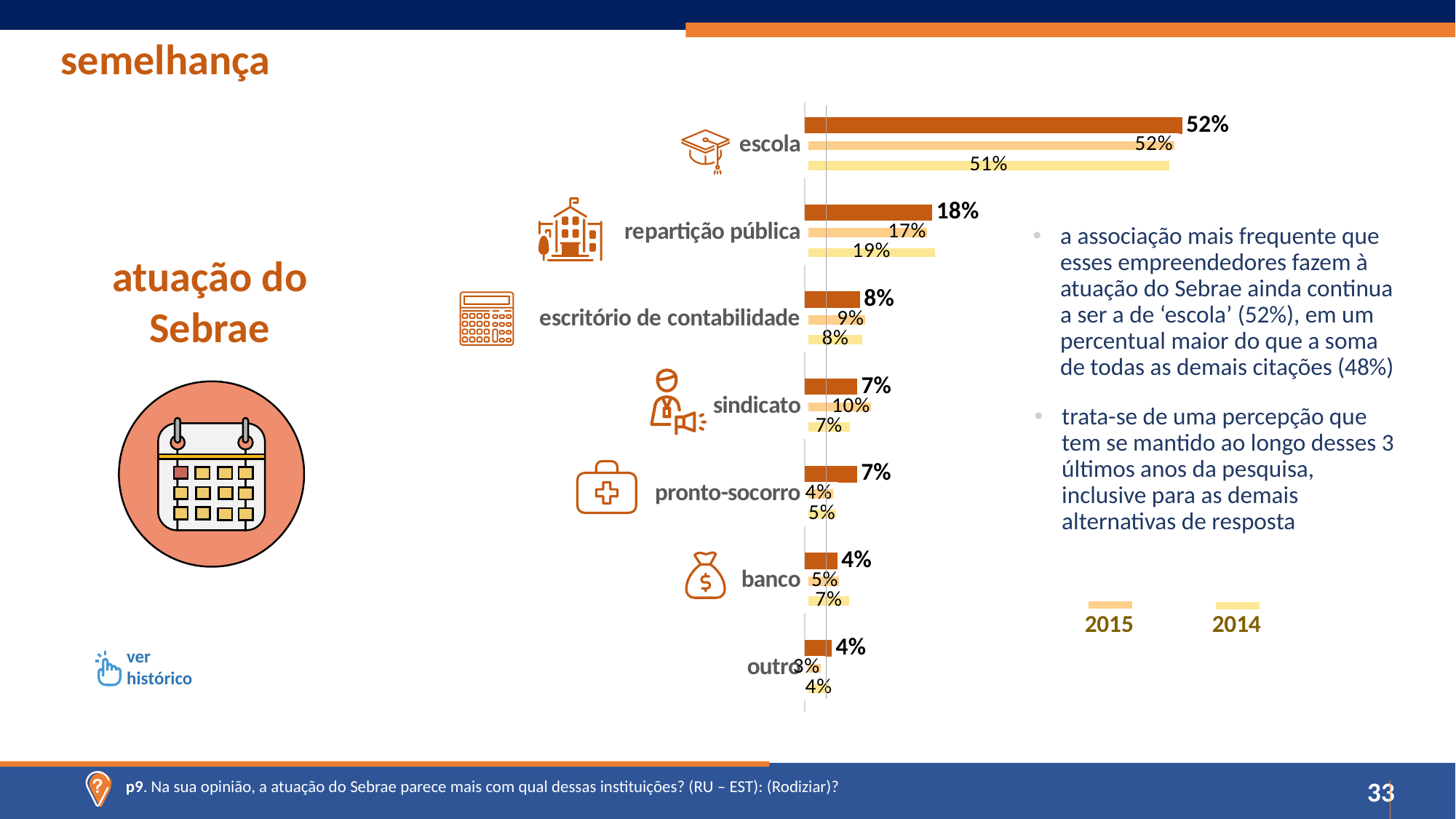
What is the 2014 value for 'repartição pública'? 19% What is the 2015 value for 'sindicato'? 10% Which has the larger 2014 value, 'banco' or 'pronto-socorro'? banco What is the difference between the 2015 values for 'escola' and 'repartição pública'? 35% What is the 2015 value for 'escola'? 52% What is the value shown on the dark orange bar for 'pronto-socorro'? 7% How many series does the legend list? 2 What is the difference between the 2014 values for 'escola' and 'repartição pública'? 32% How many categories are shown in the chart? 7 Which category has the highest 2014 value? escola What kind of chart is shown on the slide? bar chart Which category has the lowest 2015 value? outro